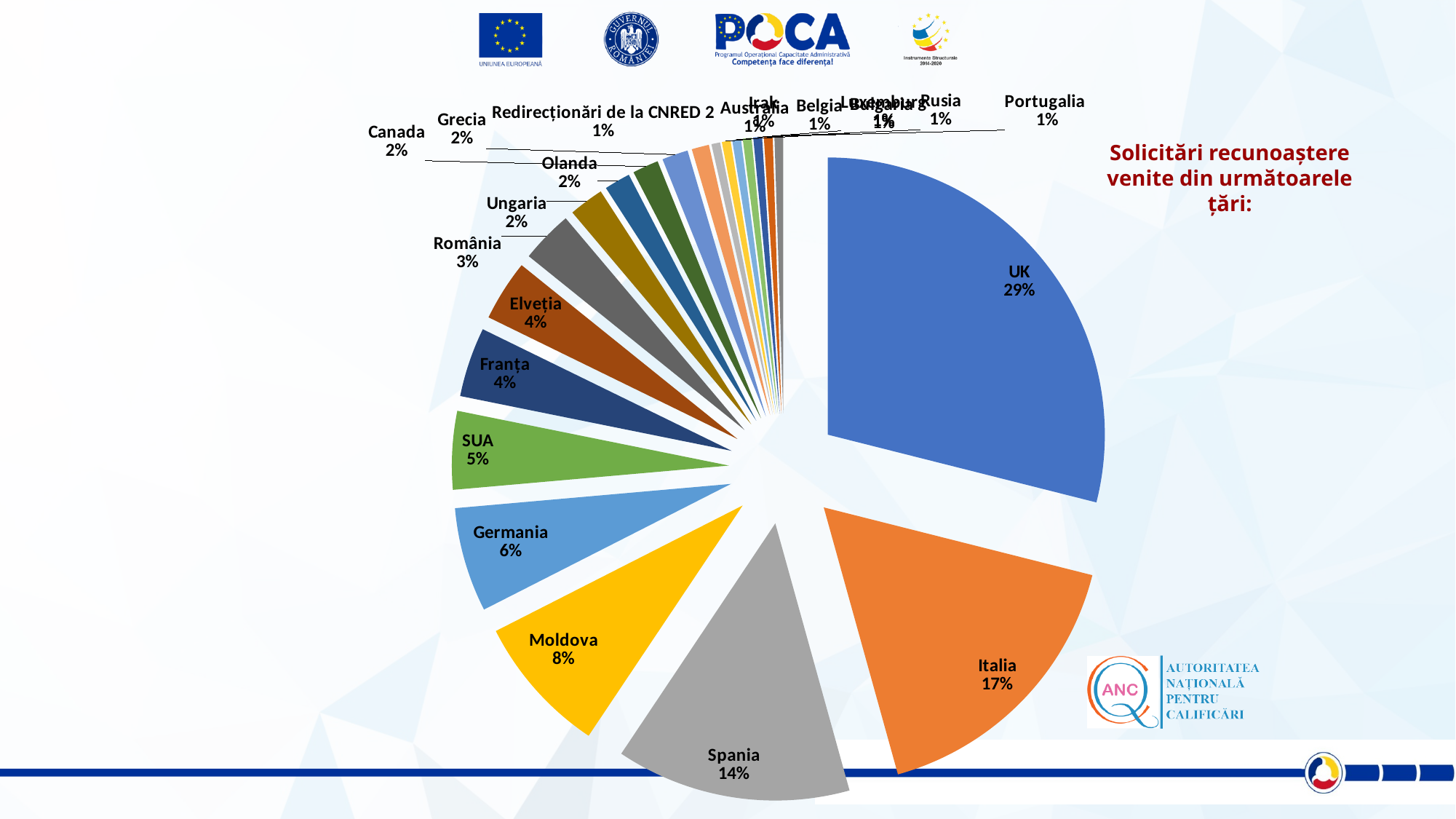
What is the share for Germania? 6% What is the difference in percentage points between UK and Italia? 12 What is the share for Spania? 14% Which country has the largest slice of the pie? UK What is the share for Italia? 17% What is the share for Moldova? 8% Which is larger, the share for Spania or the share for Moldova? Spania What is the title of the chart? Solicitări recunoaștere venite din următoarele țări: What kind of chart is shown on the slide? pie chart What is the difference in percentage points between Germania and SUA? 1 What is the share for UK? 29% What is the share for România? 3%